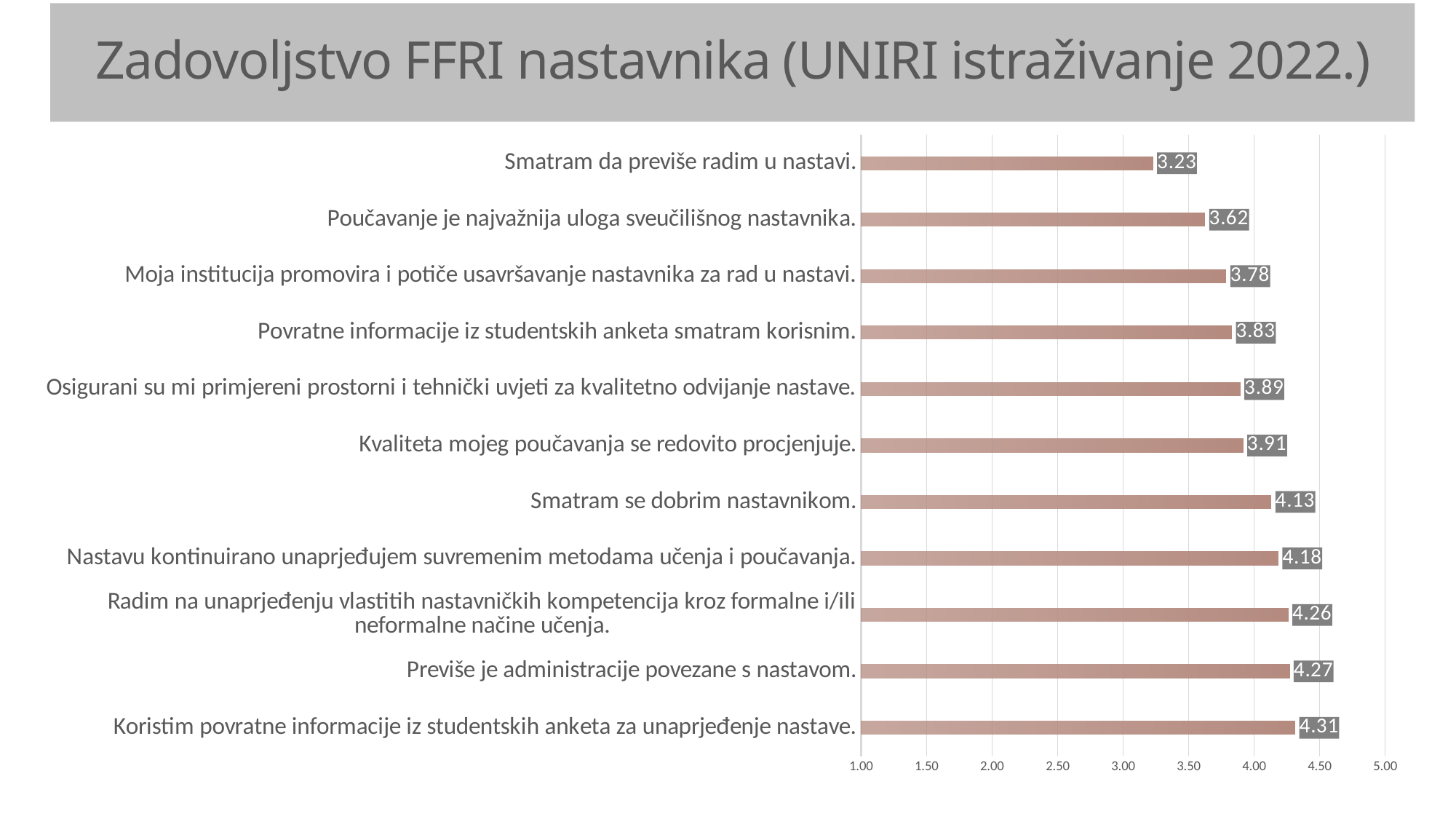
What is the value for "Smatram da previše radim u nastavi."? 3.23 Which category has the lowest value? Smatram da previše radim u nastavi. What is the value for "Smatram se dobrim nastavnikom."? 4.13 What is the difference between the values for "Koristim povratne informacije iz studentskih anketa za unaprjeđenje nastave." and "Smatram da previše radim u nastavi."? 1.08 Is the value for "Povratne informacije iz studentskih anketa smatram korisnim." greater or less than 4.00? less How many categories are shown in the chart? 11 What kind of chart is shown on the slide? bar chart What is the title of the slide? Zadovoljstvo FFRI nastavnika (UNIRI istraživanje 2022.) Which category has the highest value? Koristim povratne informacije iz studentskih anketa za unaprjeđenje nastave. What is the value for "Previše je administracije povezane s nastavom."? 4.27 Which has a larger value: "Poučavanje je najvažnija uloga sveučilišnog nastavnika." or "Kvaliteta mojeg poučavanja se redovito procjenjuje."? Kvaliteta mojeg poučavanja se redovito procjenjuje. What is the maximum value shown on the horizontal axis? 5.00